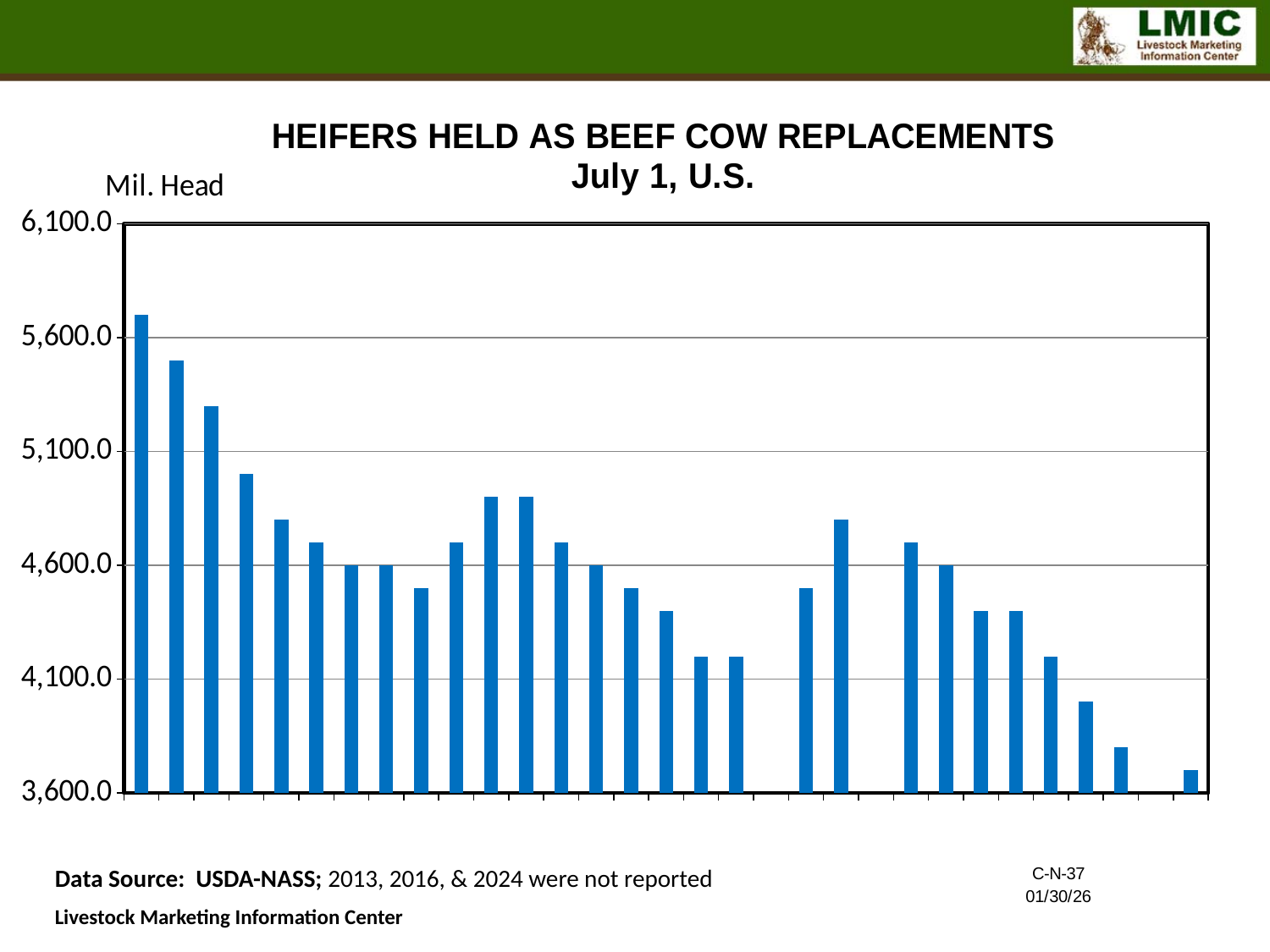
Do the bar values generally rise or fall from left to right across the chart? Fall Is the value of the leftmost bar greater or less than 5,600.0? greater Which bar is the tallest in the chart? The leftmost (first) bar Which bar is the shortest in the chart? The rightmost (last) bar Is the value of the rightmost bar greater or less than 3,600.0? greater What unit label is shown on the vertical axis of the chart? Mil. Head What is the lowest value shown on the vertical axis of the chart? 3,600.0 Is the value of the rightmost bar greater or less than 4,100.0? less What is the title of the chart? HEIFERS HELD AS BEEF COW REPLACEMENTS, July 1, U.S. What kind of chart is shown on the slide? Bar chart Which is larger, the value of the leftmost bar or the value of the rightmost bar? The leftmost bar